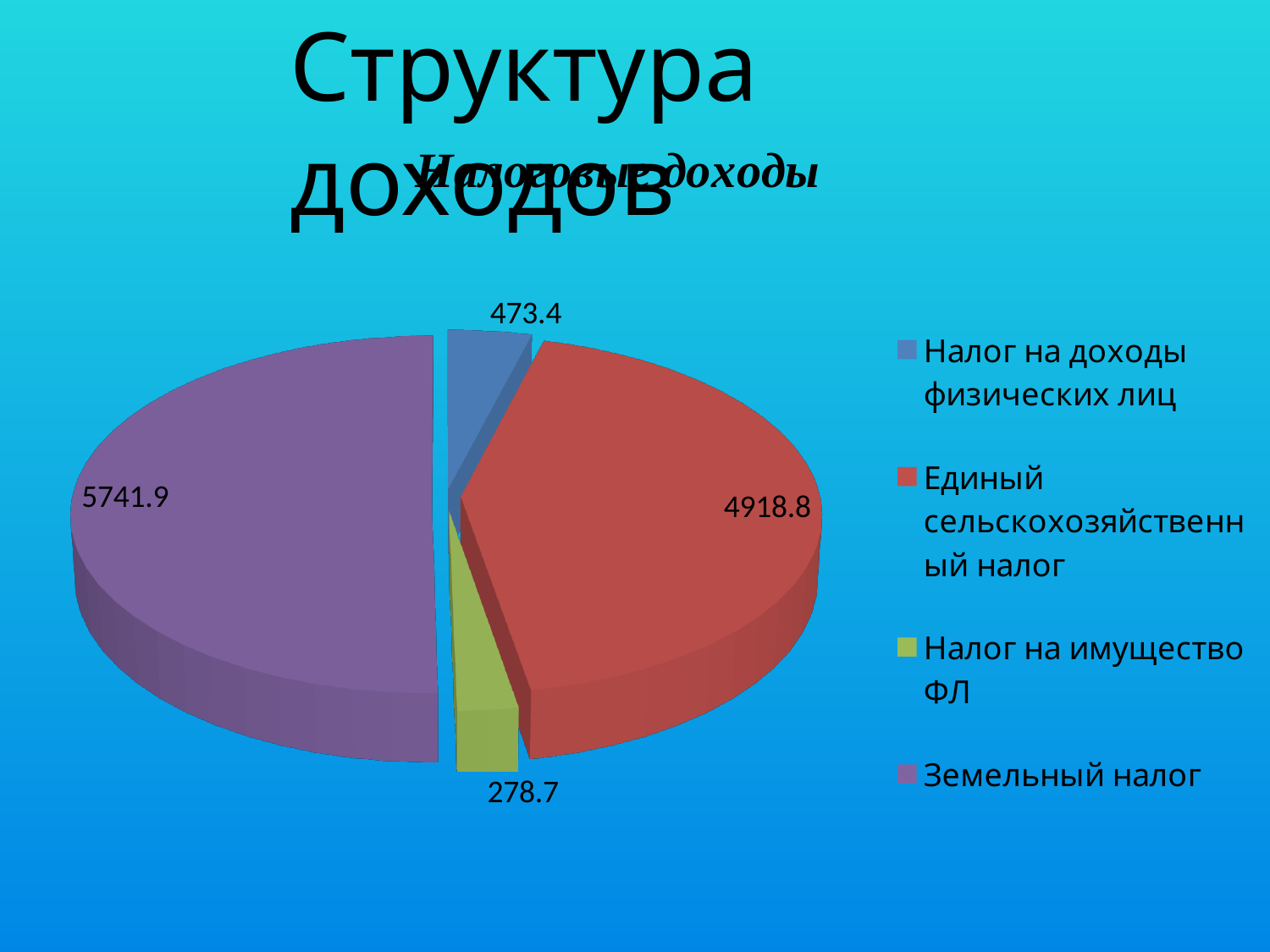
Which category has the largest slice of the pie? Земельный налог What is the difference between the values for Налог на доходы физических лиц and Налог на имущество ФЛ? 194.7 How many slices does the pie chart have? 4 What is the value for Земельный налог? 5741.9 What is the value for Единый сельскохозяйственный налог? 4918.8 Which is larger: Налог на доходы физических лиц or Налог на имущество ФЛ? Налог на доходы физических лиц What colour is the slice for Единый сельскохозяйственный налог? Red Which category has the smallest slice of the pie? Налог на имущество ФЛ What is the value for Налог на имущество ФЛ? 278.7 What type of chart is shown on the slide? Pie chart What is the difference between the values for Земельный налог and Единый сельскохозяйственный налог? 823.1 What is the value for Налог на доходы физических лиц? 473.4